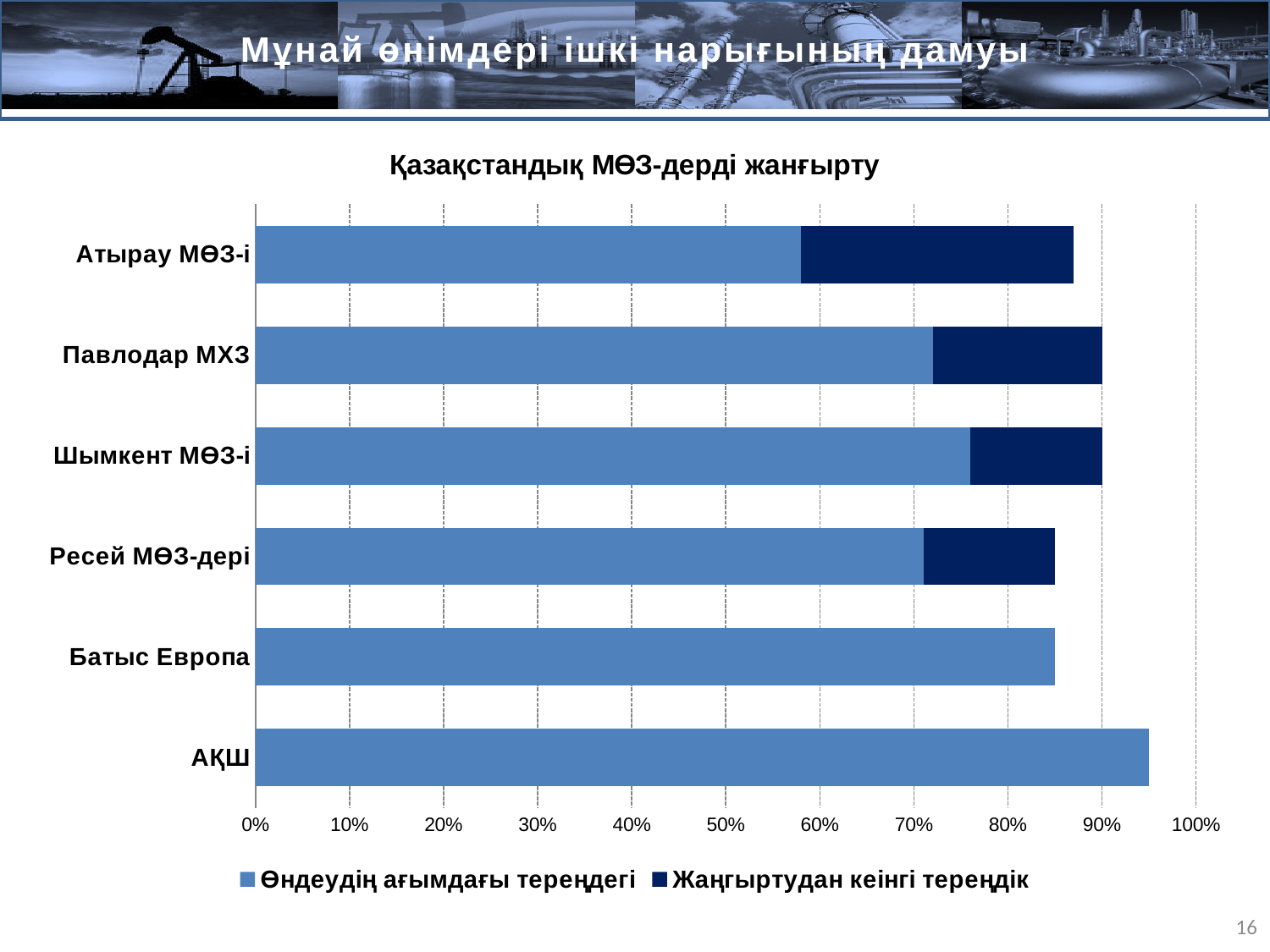
Is the value for Батыс Европа greater or less than 80%? greater Which category has the lowest value for Өндеудің ағымдағы тереңдегі? Атырау МӨЗ-і Is the value for АҚШ greater or less than 90%? greater How many categories are shown on the chart? 6 Which has the larger Өндеудің ағымдағы тереңдегі value, АҚШ or Батыс Европа? АҚШ Which category has the highest value for Өндеудің ағымдағы тереңдегі? АҚШ What kind of chart is shown on the slide? bar chart What is the title of the chart? Қазақстандық МӨЗ-дерді жанғырту How many series does the legend list? 2 Which has the larger Өндеудің ағымдағы тереңдегі value, Атырау МӨЗ-і or Павлодар МХЗ? Павлодар МХЗ Is the Өндеудің ағымдағы тереңдегі value for Павлодар МХЗ greater or less than 80%? less